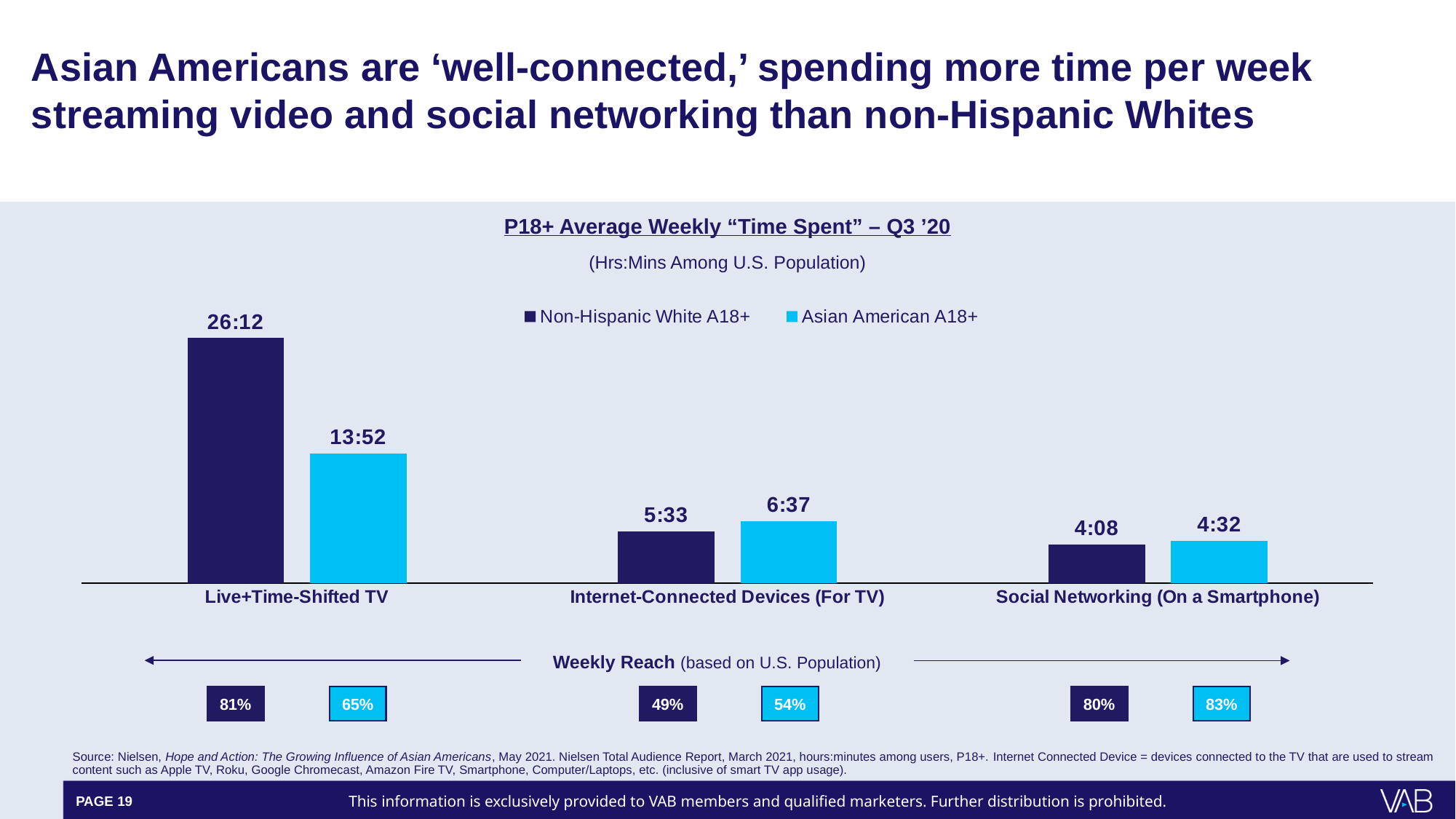
What is the title of the chart? P18+ Average Weekly "Time Spent" – Q3 '20 How many series does the chart's legend list? 2 Which is larger for Live+Time-Shifted TV: Non-Hispanic White A18+ or Asian American A18+? Non-Hispanic White A18+ Which category has the lowest value for Non-Hispanic White A18+? Social Networking (On a Smartphone) Which is larger for Internet-Connected Devices (For TV): Non-Hispanic White A18+ or Asian American A18+? Asian American A18+ What is the value for Asian American A18+ for Social Networking (On a Smartphone)? 4:32 What is the value for Non-Hispanic White A18+ for Social Networking (On a Smartphone)? 4:08 How many categories are shown on the x axis of the chart? 3 What is the value for Asian American A18+ for Internet-Connected Devices (For TV)? 6:37 Which category has the highest value for Asian American A18+? Live+Time-Shifted TV What kind of chart is shown on the slide? Bar chart What is the value for Non-Hispanic White A18+ for Live+Time-Shifted TV? 26:12